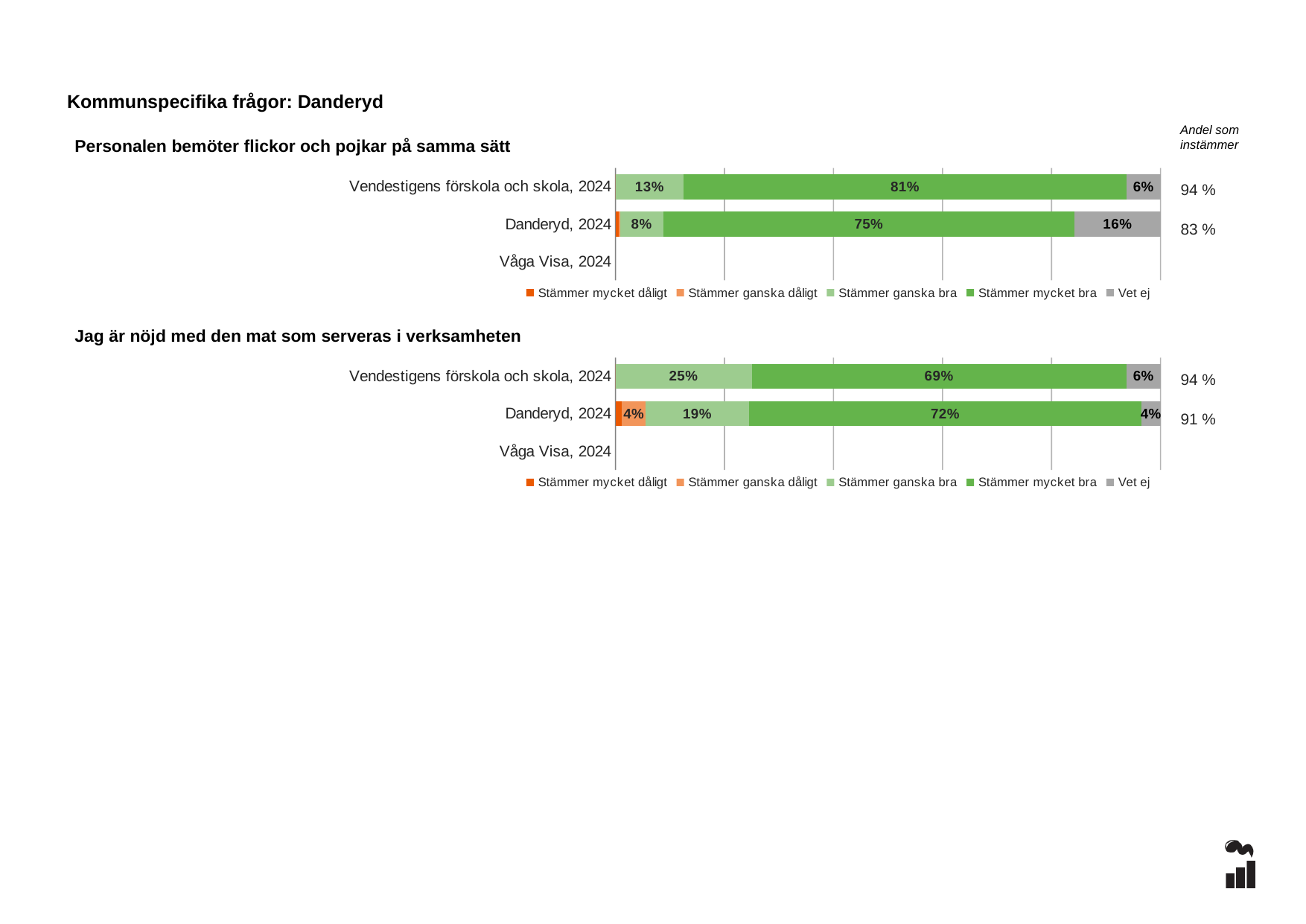
In the chart 'Jag är nöjd med den mat som serveras i verksamheten', what is the 'Stämmer ganska dåligt' value for Danderyd, 2024? 4% What kind of chart is 'Personalen bemöter flickor och pojkar på samma sätt'? Stacked horizontal bar chart In the chart 'Jag är nöjd med den mat som serveras i verksamheten', what is the 'Andel som instämmer' value shown for Danderyd, 2024? 91 % How many series does the legend of the chart 'Jag är nöjd med den mat som serveras i verksamheten' list? 5 In the chart 'Personalen bemöter flickor och pojkar på samma sätt', what is the 'Stämmer ganska bra' value for Danderyd, 2024? 8% In the chart 'Personalen bemöter flickor och pojkar på samma sätt', what is the 'Vet ej' value for Danderyd, 2024? 16% In the chart 'Jag är nöjd med den mat som serveras i verksamheten', which has the larger 'Stämmer mycket bra' value: Vendestigens förskola och skola, 2024 or Danderyd, 2024? Danderyd, 2024 In the chart 'Jag är nöjd med den mat som serveras i verksamheten', what is the 'Stämmer mycket bra' value for Danderyd, 2024? 72% In the chart 'Personalen bemöter flickor och pojkar på samma sätt', which has the larger 'Vet ej' value: Vendestigens förskola och skola, 2024 or Danderyd, 2024? Danderyd, 2024 In the chart 'Jag är nöjd med den mat som serveras i verksamheten', what is the 'Stämmer ganska bra' value for Vendestigens förskola och skola, 2024? 25% In the chart 'Personalen bemöter flickor och pojkar på samma sätt', what is the difference between the 'Stämmer mycket bra' values for Vendestigens förskola och skola, 2024 and Danderyd, 2024? 6% In the chart 'Personalen bemöter flickor och pojkar på samma sätt', what is the 'Stämmer mycket bra' value for Vendestigens förskola och skola, 2024? 81%